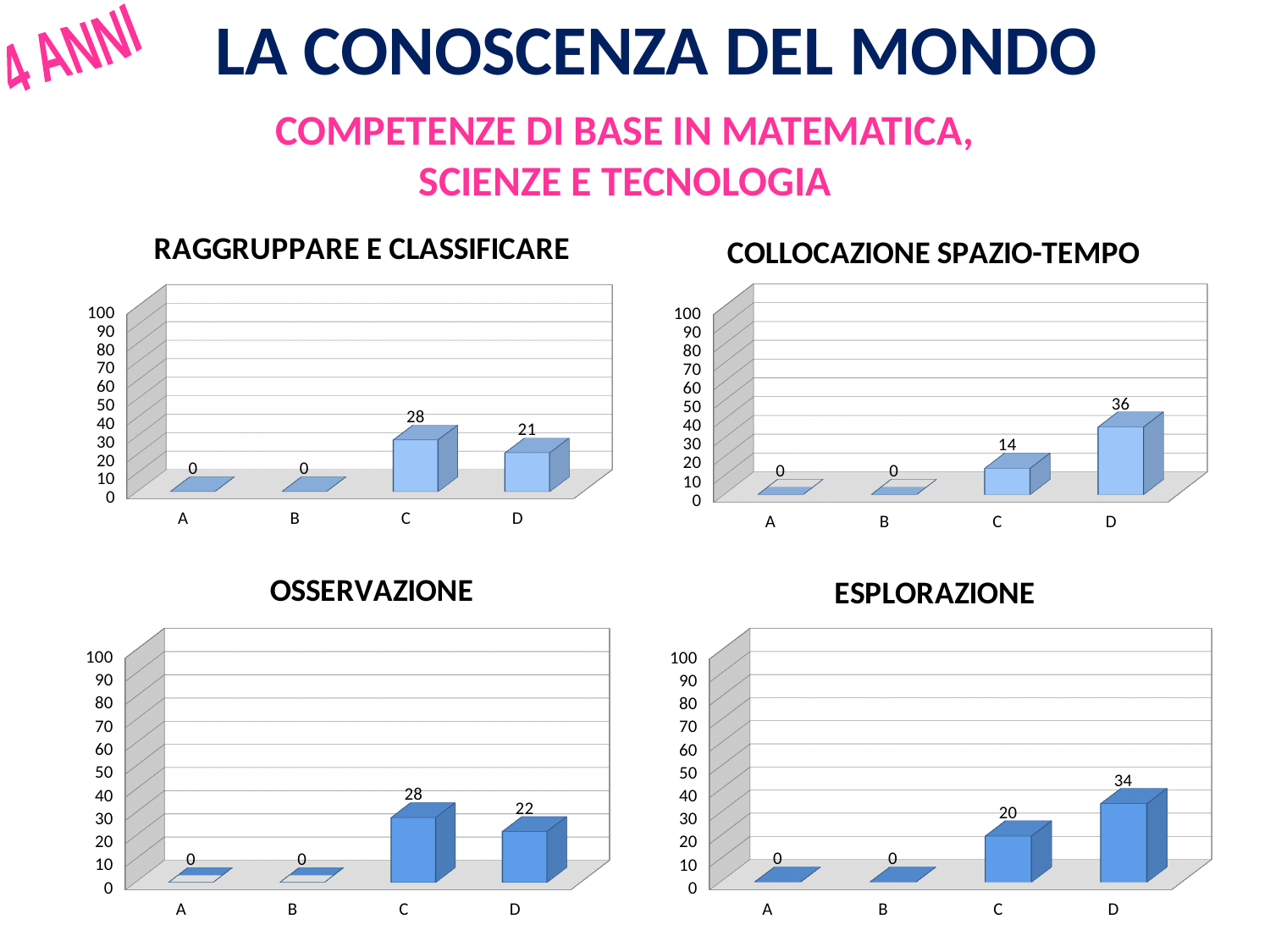
In the OSSERVAZIONE chart, what is the value for category D? 22 In the ESPLORAZIONE chart, which category has the highest value? D In the COLLOCAZIONE SPAZIO-TEMPO chart, what is the value for category D? 36 In the ESPLORAZIONE chart, which is larger, the value for C or the value for D? D In the OSSERVAZIONE chart, what is the difference between the values for C and D? 6 In the COLLOCAZIONE SPAZIO-TEMPO chart, what is the difference between the values for D and C? 22 What kind of chart is the ESPLORAZIONE chart? Bar chart In the COLLOCAZIONE SPAZIO-TEMPO chart, is the value for D greater or less than 30? greater In the RAGGRUPPARE E CLASSIFICARE chart, which category has the highest value? C How many categories are shown on the x axis of the OSSERVAZIONE chart? 4 In the ESPLORAZIONE chart, what is the value for category C? 20 In the RAGGRUPPARE E CLASSIFICARE chart, what is the value for category C? 28